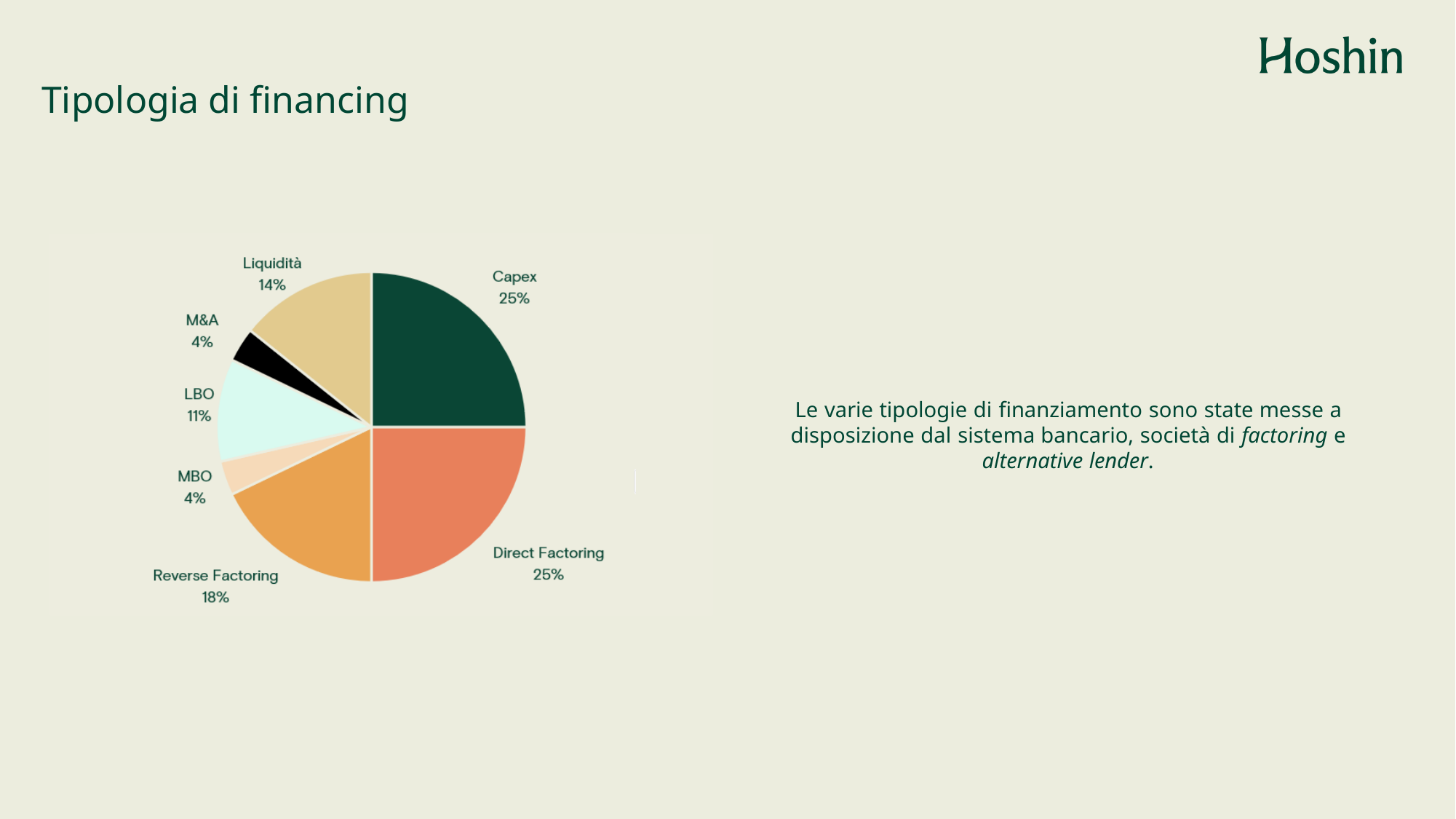
What kind of chart is shown on the slide? Pie chart What share of the pie does LBO represent? 11% What share of the pie does Reverse Factoring represent? 18% What share of the pie does Capex represent? 25% How many categories are shown in the pie chart? 7 What share of the pie does MBO represent? 4% What is the title of the slide containing the chart? Tipologia di financing What is the difference in percentage points between Liquidità and LBO? 3 Which category has the smallest share, Liquidità or LBO? LBO What is the difference in percentage points between Direct Factoring and Reverse Factoring? 7 Which is larger, Reverse Factoring or Liquidità? Reverse Factoring What share of the pie does Liquidità represent? 14%